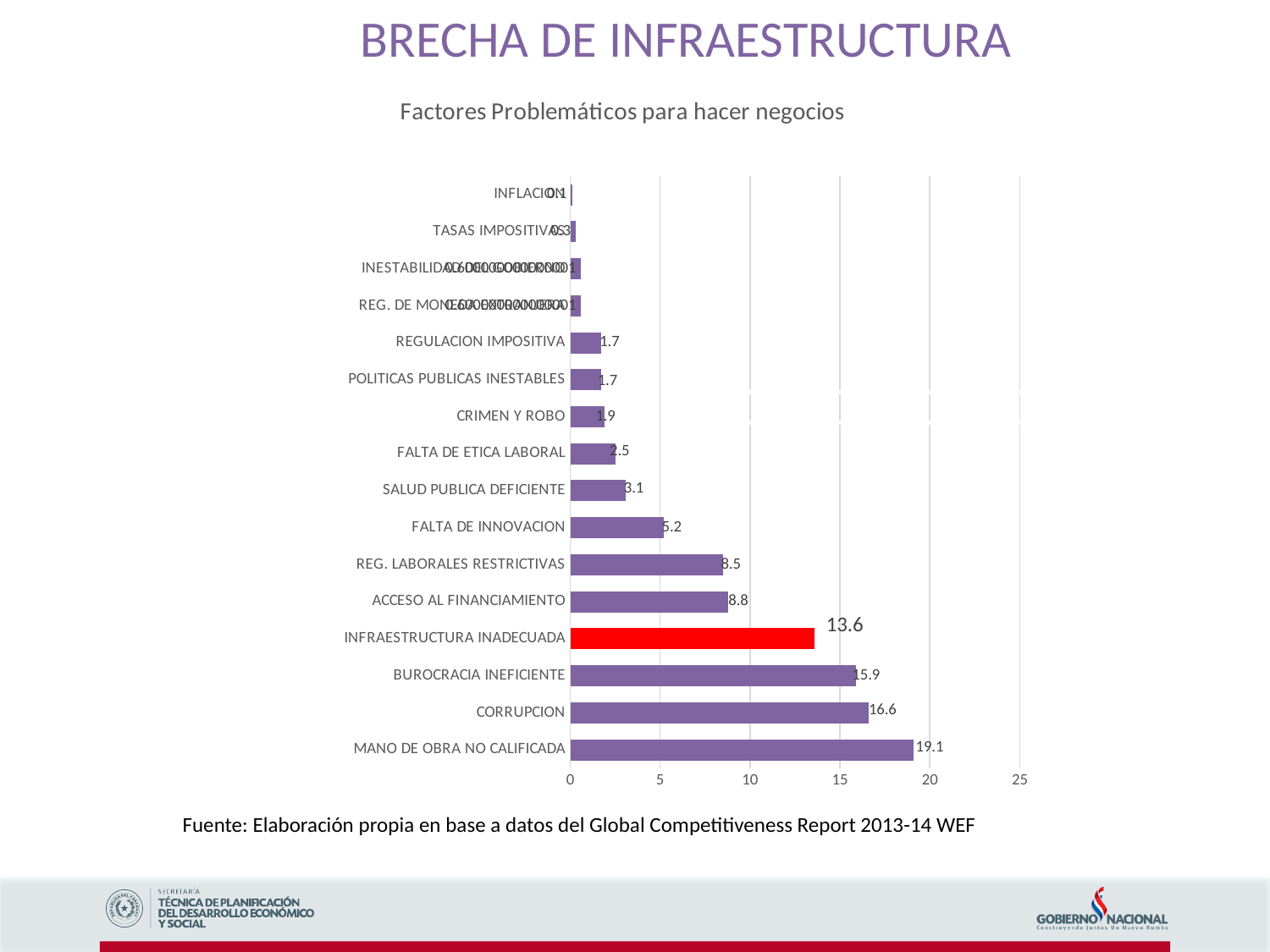
What is the difference between the values for CORRUPCION and BUROCRACIA INEFICIENTE? 0.7 Which category has the highest value? MANO DE OBRA NO CALIFICADA What is the title of the chart? Factores Problemáticos para hacer negocios What kind of chart is shown on the slide? bar chart How many categories are plotted in the chart? 16 What is the value for CORRUPCION? 16.6 Is the value for BUROCRACIA INEFICIENTE greater or less than 10? greater What is the value for MANO DE OBRA NO CALIFICADA? 19.1 What is the value for FALTA DE INNOVACION? 5.2 What is the value for INFRAESTRUCTURA INADECUADA? 13.6 Which is larger, the value for ACCESO AL FINANCIAMIENTO or the value for FALTA DE INNOVACION? ACCESO AL FINANCIAMIENTO Which bar is coloured red instead of purple? INFRAESTRUCTURA INADECUADA